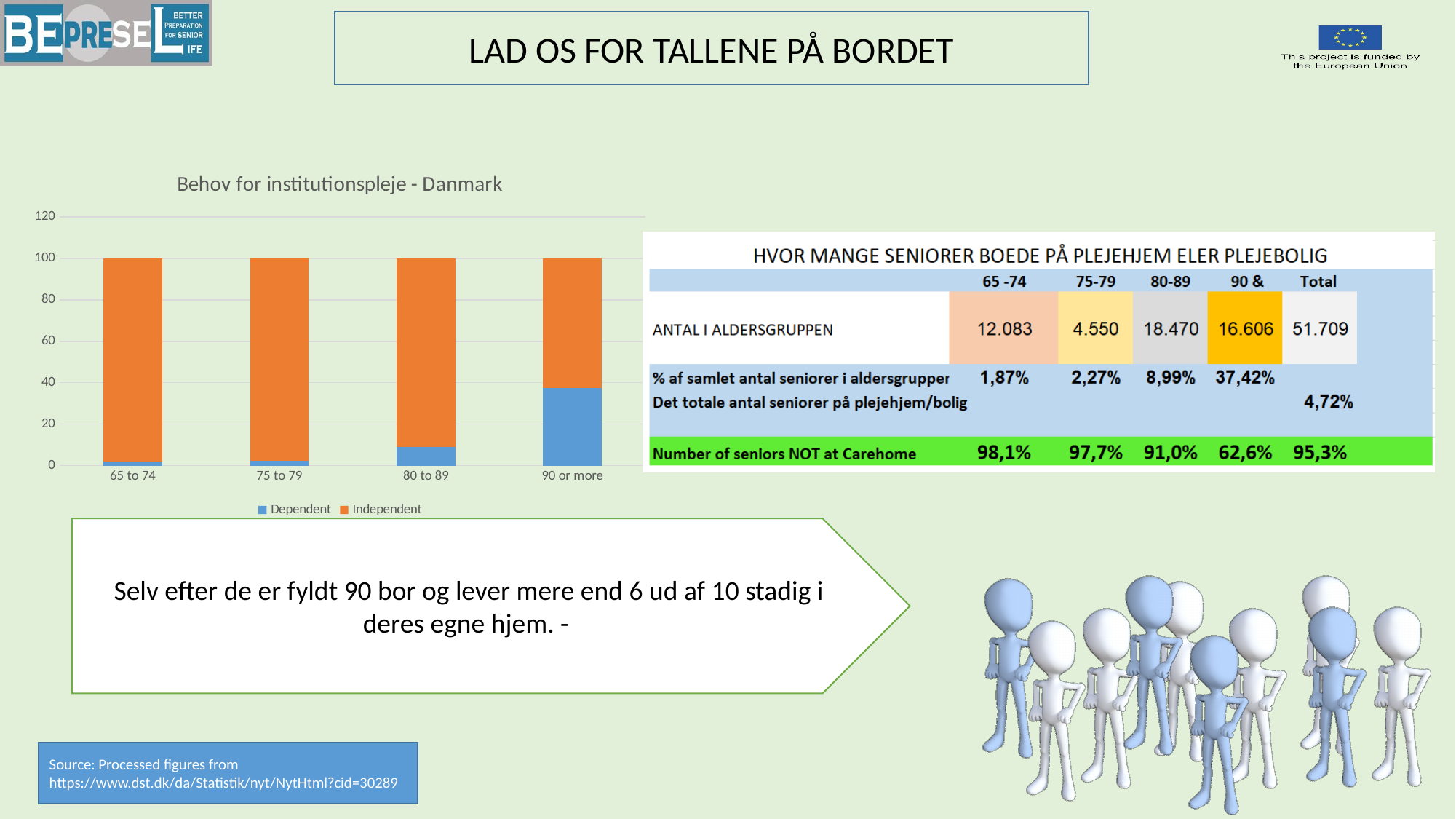
How many series does the legend of the 'Behov for institutionspleje - Danmark' chart list? 2 How many age categories are shown on the x axis of the 'Behov for institutionspleje - Danmark' chart? 4 In the 'Behov for institutionspleje - Danmark' chart, is the Dependent value for '80 to 89' greater or less than 20? less Which colour represents the Dependent series in the 'Behov for institutionspleje - Danmark' chart? blue In the 'Behov for institutionspleje - Danmark' chart, which age category has the largest Dependent segment? 90 or more In the 'Behov for institutionspleje - Danmark' chart, does the Dependent segment rise or fall as age increases along the x axis? rises In the 'Behov for institutionspleje - Danmark' chart, is the Dependent value for '90 or more' greater or less than 40? less In the 'Behov for institutionspleje - Danmark' chart, which is larger for '90 or more': the Dependent segment or the Independent segment? Independent What are the two legend entries of the 'Behov for institutionspleje - Danmark' chart? Dependent and Independent In the 'Behov for institutionspleje - Danmark' chart, which age category has the smallest Independent segment? 90 or more What kind of chart is 'Behov for institutionspleje - Danmark'? bar chart In the 'Behov for institutionspleje - Danmark' chart, is the Dependent value for '90 or more' greater or less than 20? greater